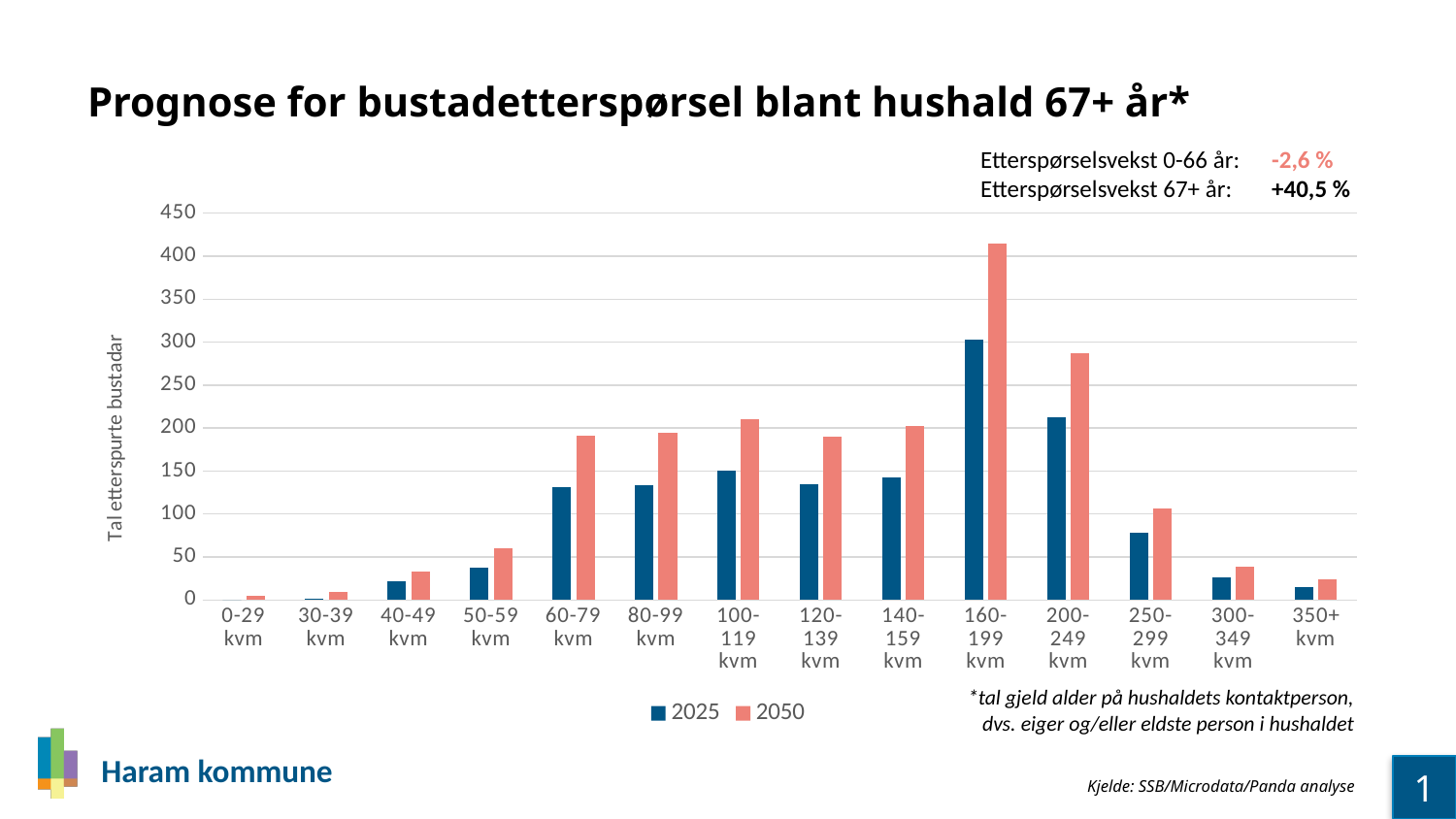
For the 2025 series, which is larger: the value for 200-249 kvm or the value for 140-159 kvm? 200-249 kvm Which size category has the highest value for the 2050 series? 160-199 kvm What kind of chart is shown on the slide? bar chart Is the 2050 value for 200-249 kvm greater or less than 300? less How many size categories are shown on the x axis? 14 Is the 2050 value for 160-199 kvm greater or less than 400? greater Which size category has the highest value for the 2025 series? 160-199 kvm How many series does the legend list? 2 For the 160-199 kvm category, which series has the larger value, 2025 or 2050? 2050 Is the 2025 value for 50-59 kvm greater or less than 50? less What is the title of the chart? Prognose for bustadetterspørsel blant hushald 67+ år*